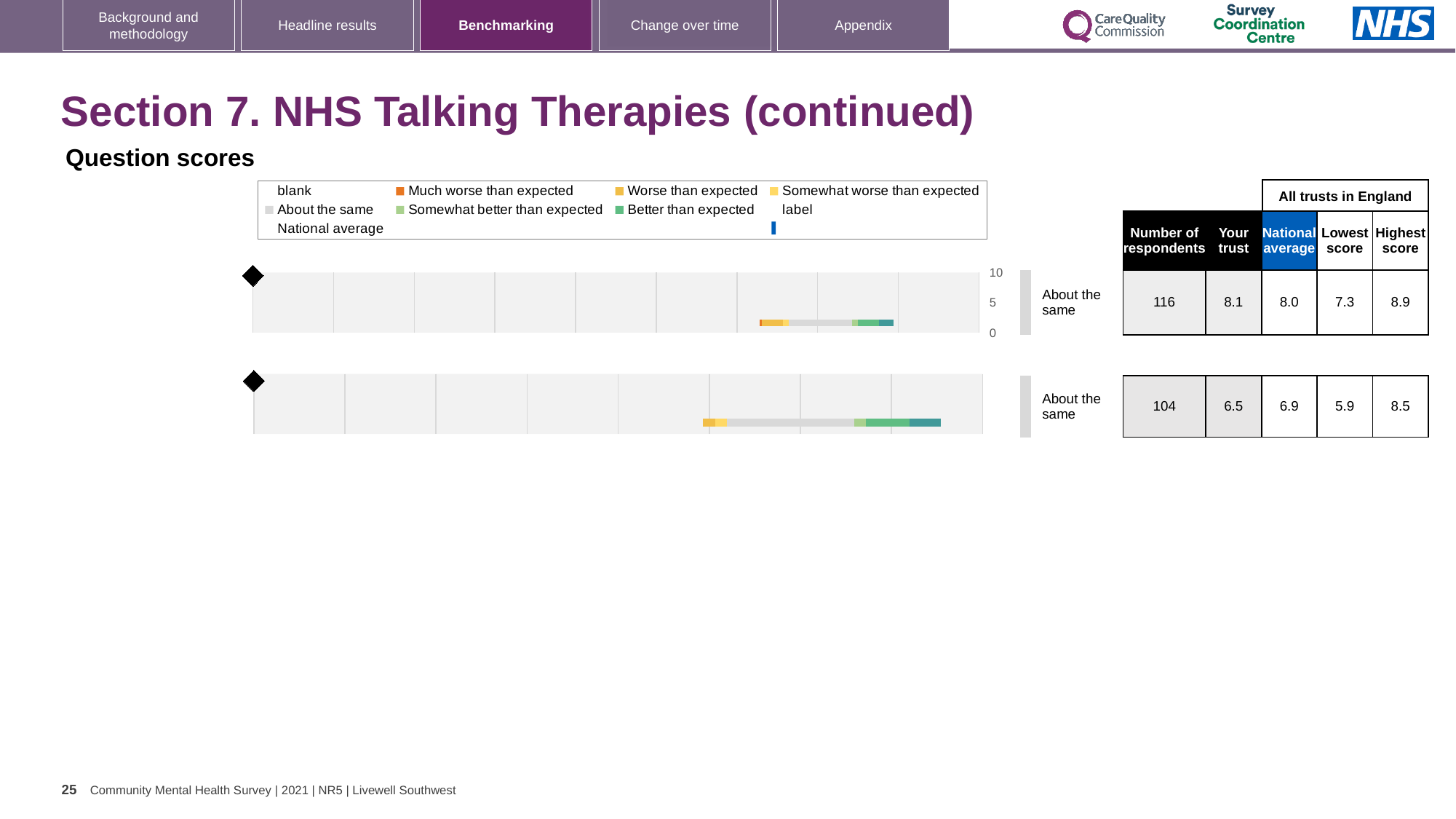
In the top chart, how many respondents are there? 116 In the bottom chart, what is the difference between the Highest score and the Lowest score? 2.6 In the top chart, what is the difference between the Highest score and the Lowest score? 1.6 What kind of chart is used on this slide to show the question scores? Bar chart What benchmark category is shown for the bottom chart? About the same In the top chart, what is the score for Your trust? 8.1 In the top chart, which is larger: the Your trust score or the National average? Your trust In the top chart, what is the National average score? 8.0 In the top chart, what is the Highest score among all trusts in England? 8.9 In the bottom chart, what is the score for Your trust? 6.5 In the bottom chart, what is the Lowest score among all trusts in England? 5.9 In the bottom chart, what is the National average score? 6.9